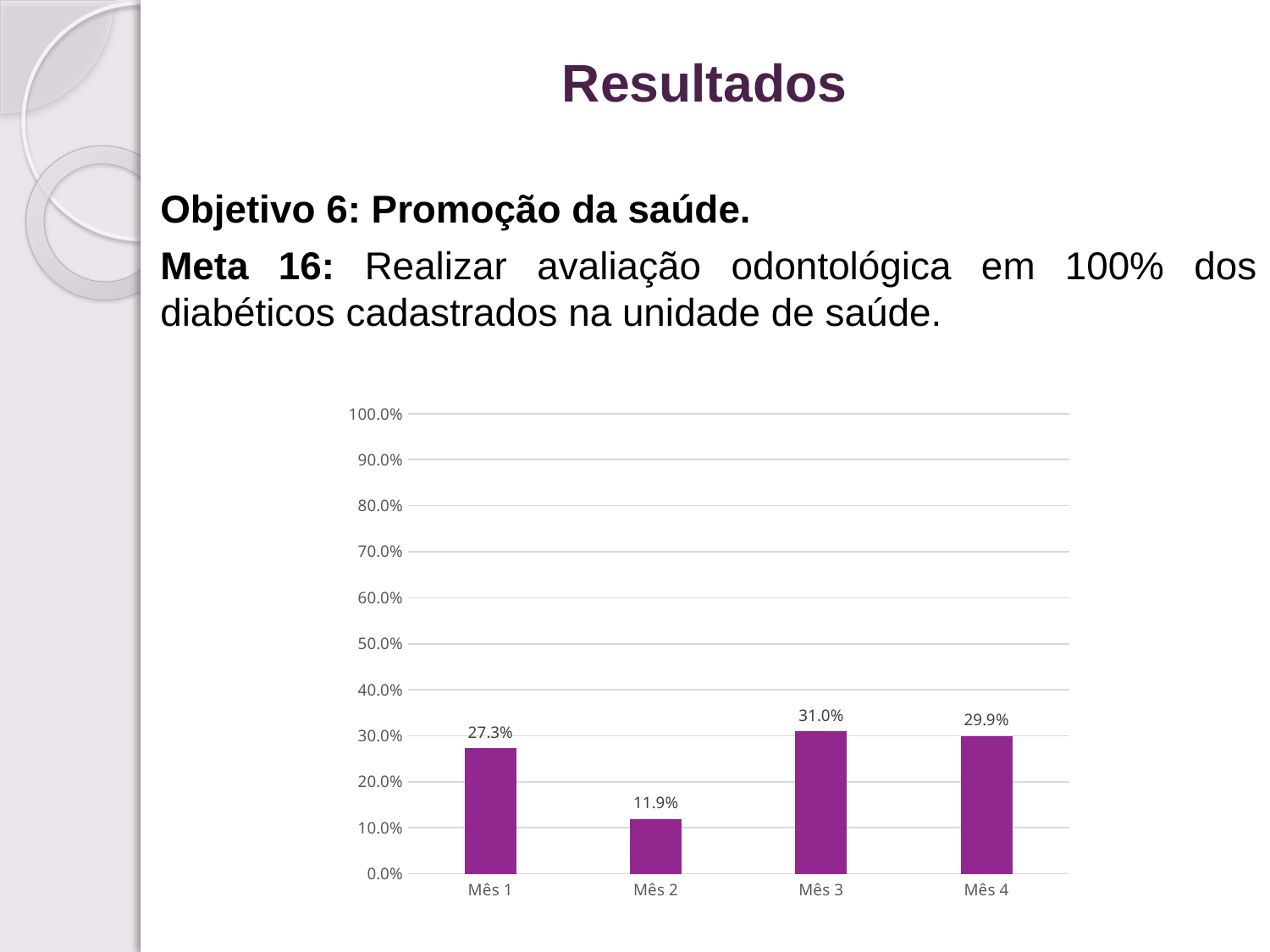
How many months are shown on the x axis? 4 Which is larger, the value for Mês 1 or the value for Mês 2? Mês 1 What is the value for Mês 1? 27.3% Which month has the highest value? Mês 3 What kind of chart is shown on the slide? Bar chart What is the difference between the values for Mês 1 and Mês 2? 15.4% What is the value for Mês 4? 29.9% What is the difference between the values for Mês 3 and Mês 2? 19.1% What is the value for Mês 3? 31.0% What is the value for Mês 2? 11.9% Is the value for Mês 4 greater or less than 20.0%? greater Which month has the lowest value? Mês 2